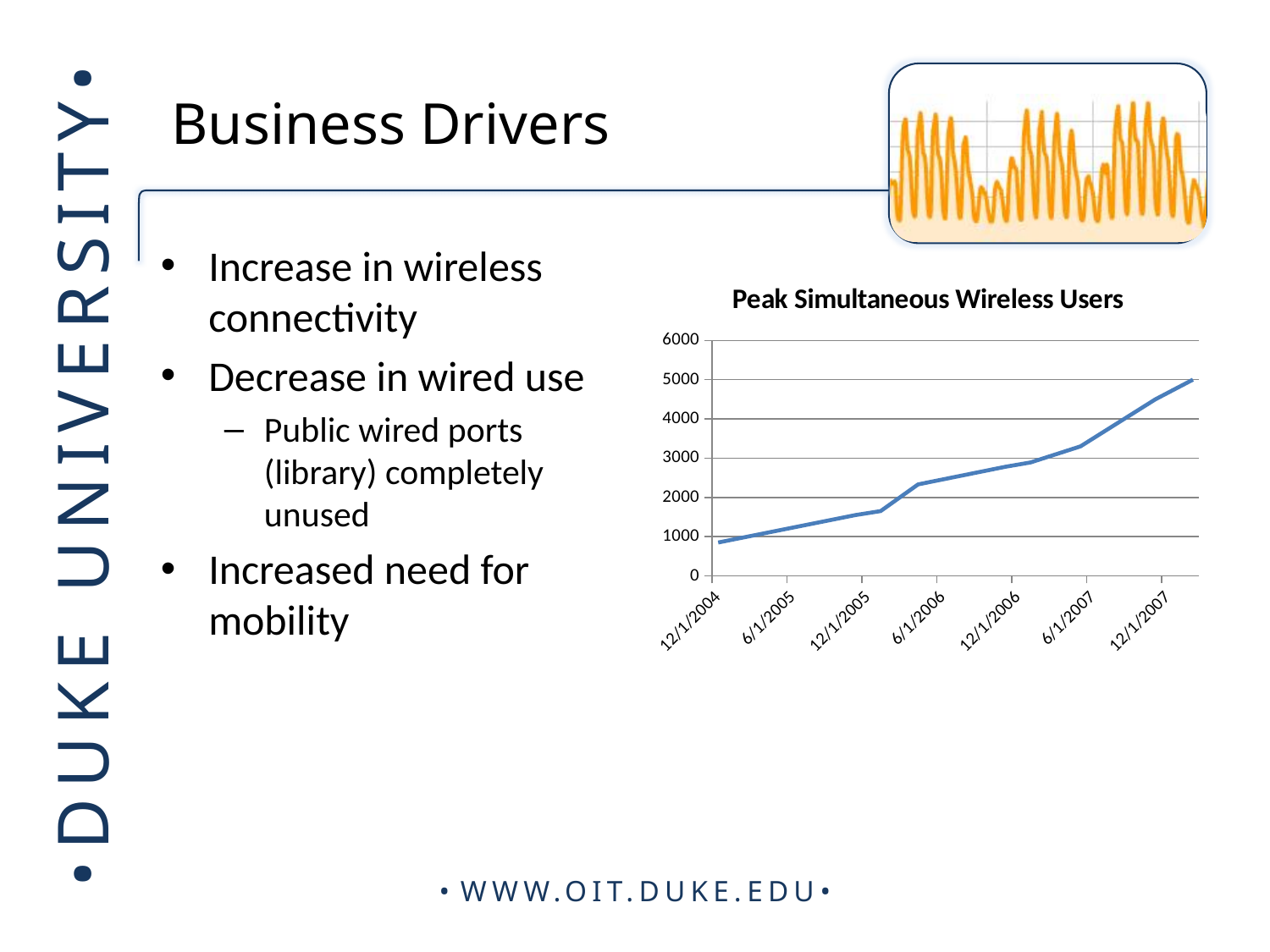
Which is larger, the value for 6/1/2007 or the value for 6/1/2006? 6/1/2007 Do the values in the Peak Simultaneous Wireless Users chart rise or fall from 12/1/2004 to 12/1/2007? rise Is the value for 12/1/2007 greater or less than 4000? greater How many date labels are shown on the x axis of the chart? 7 Is the value for 6/1/2006 greater or less than 2000? greater Is the value for 12/1/2004 greater or less than 1000? less What is the title of the chart on the slide? Peak Simultaneous Wireless Users What kind of chart is shown on the slide? line chart Which date has the lowest value in the Peak Simultaneous Wireless Users chart? 12/1/2004 Which date has the highest value in the Peak Simultaneous Wireless Users chart? 12/1/2007